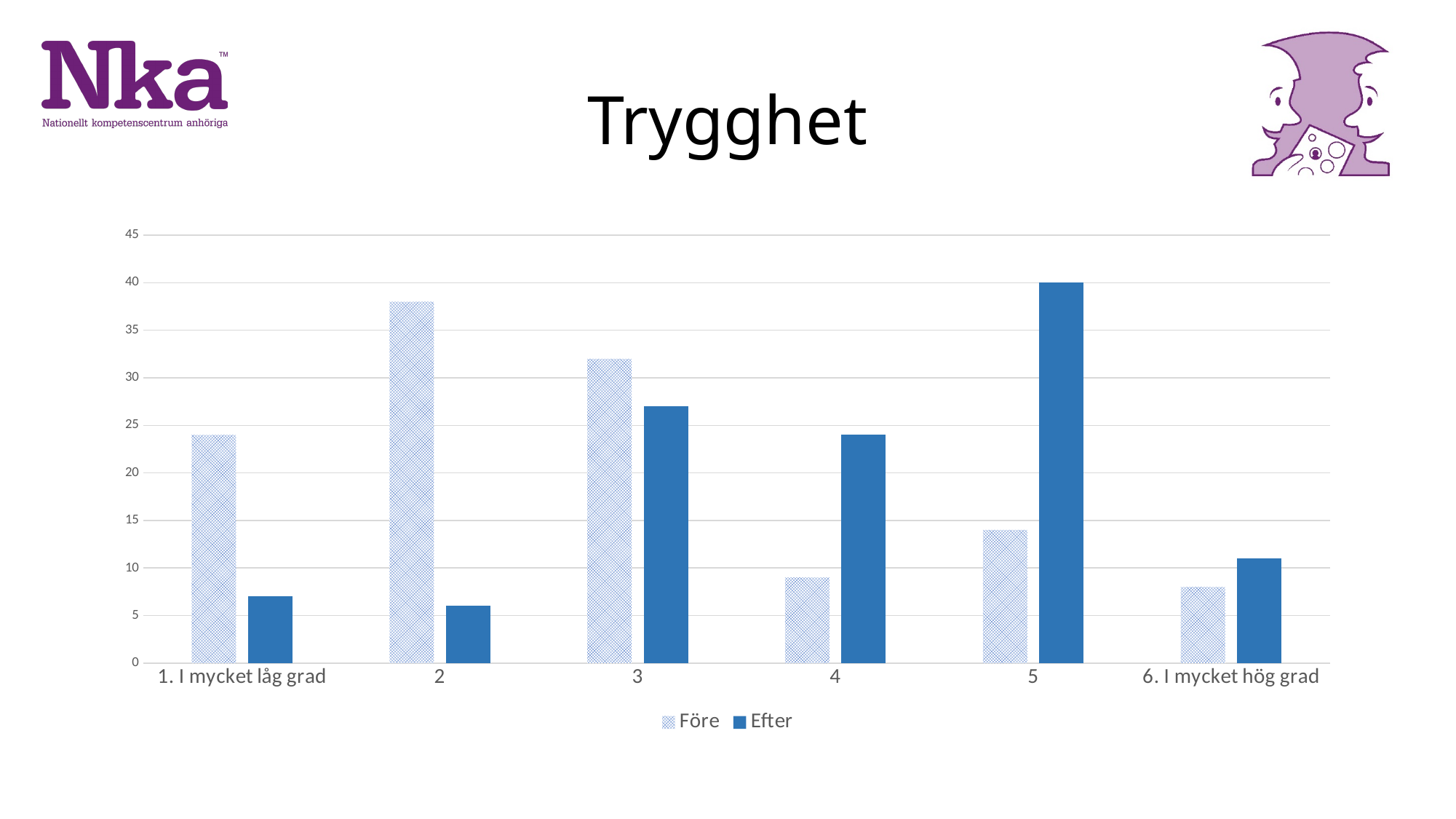
What kind of chart is shown on the slide? bar chart How many series does the legend list? 2 Which category has the lowest Efter bar? 2 Is the Före value for category 2 greater or less than 35? greater What is the title of the chart slide? Trygghet Which category has the highest Före bar? 2 How many categories are shown on the x axis? 6 What is the value of the Efter bar for category 5? 40 Is the Före value for category 4 greater or less than 10? less Is the Efter value for category 4 greater or less than 20? greater For category 3, which is larger, the Före bar or the Efter bar? Före Which category has the highest Efter bar? 5